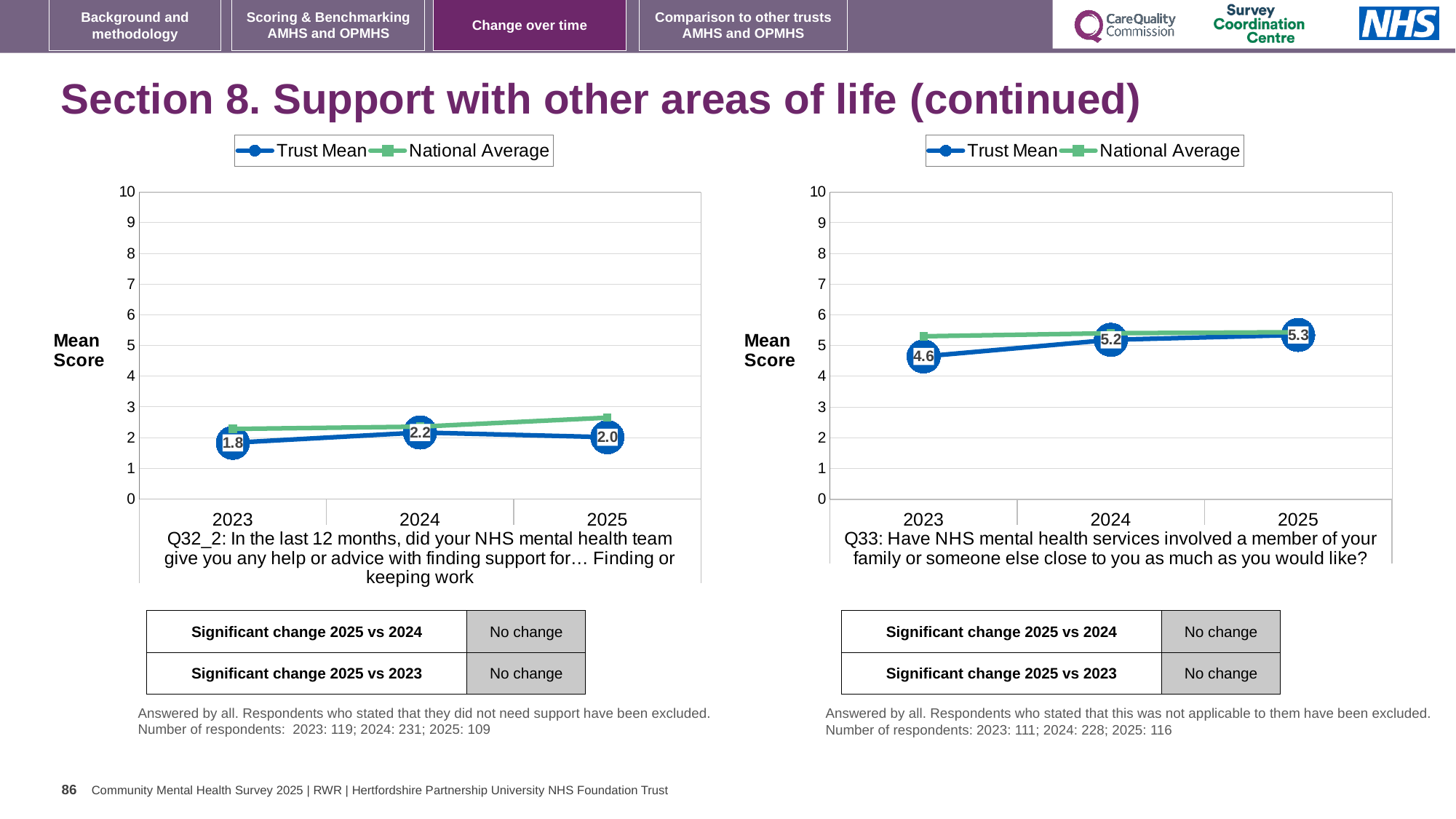
In the left chart (Q32_2), what is the difference between the Trust Mean for 2024 and 2025? 0.2 In the right chart (Q33), what is the Trust Mean for 2025? 5.3 How many years are plotted on the x axis of the left chart (Q32_2)? 3 In the right chart (Q33), does the Trust Mean rise or fall from 2023 to 2025? Rise In the right chart (Q33), which year has the lowest Trust Mean? 2023 In the right chart (Q33), what is the difference between the Trust Mean for 2024 and 2023? 0.6 What kind of chart is the right chart (Q33)? Line chart In the right chart (Q33), is the National Average for 2023 greater or less than 5? greater How many series does the legend of the right chart (Q33) list? 2 In the left chart (Q32_2), which year has the highest Trust Mean? 2024 In the left chart (Q32_2), which is larger in 2025, the Trust Mean or the National Average? National Average In the left chart (Q32_2), what is the Trust Mean for 2023? 1.8